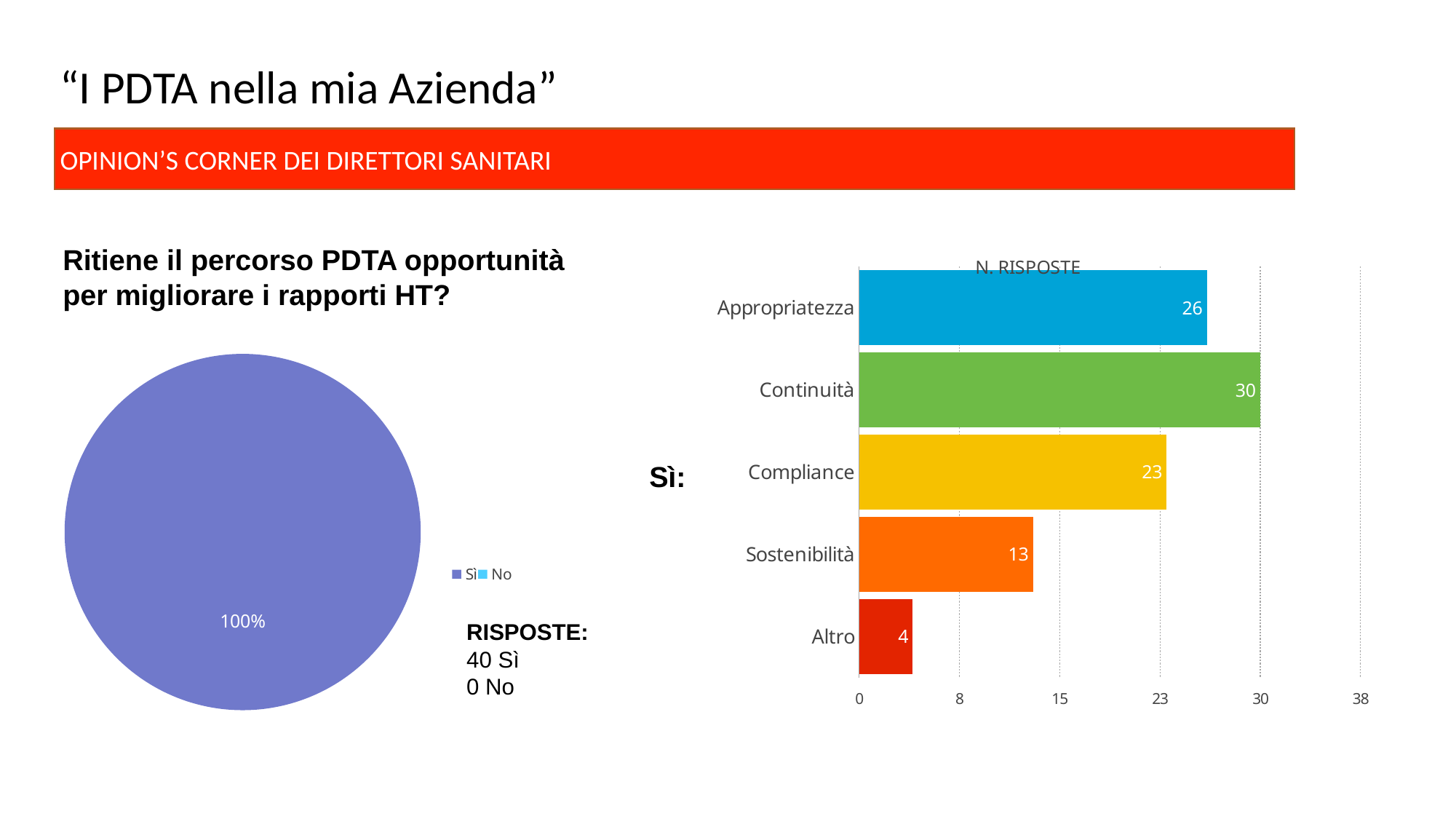
How many categories does the bar chart on the right show? 5 In the pie chart on the left, what share does the Sì slice have? 100% In the bar chart on the right, what is the value for Continuità? 30 In the bar chart on the right, which category has the lowest value? Altro In the bar chart on the right, which is larger, the value for Appropriatezza or the value for Continuità? Continuità In the bar chart on the right, what is the value for Altro? 4 In the bar chart on the right, which category has the highest value? Continuità How many entries does the legend of the pie chart on the left list? 2 What kind of chart is the chart on the right? bar chart In the bar chart on the right, what is the difference between the values for Appropriatezza and Compliance? 3 In the bar chart on the right, what is the value for Sostenibilità? 13 What is the title of the bar chart on the right? N. RISPOSTE